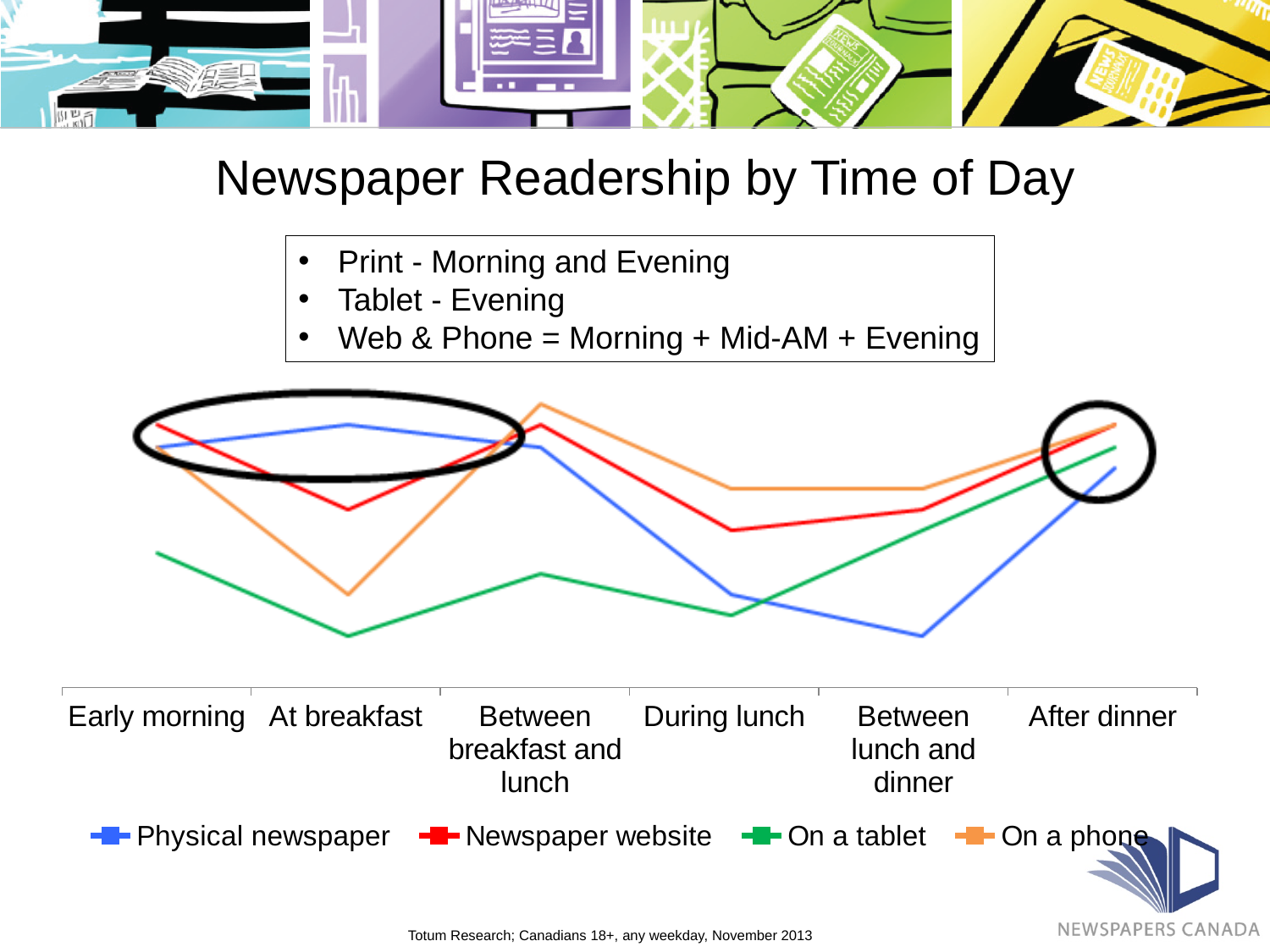
At which time of day is the "On a phone" series at its highest? Between breakfast and lunch Which series has the highest value at "During lunch"? On a phone What is the title of the chart? Newspaper Readership by Time of Day At which time of day is the "On a tablet" series at its lowest? At breakfast Does the "Physical newspaper" series rise or fall from "Between lunch and dinner" to "After dinner"? Rise How many time-of-day categories are shown on the x axis? 6 What kind of chart is shown on the slide? Line chart At which time of day is the "Physical newspaper" series at its lowest? Between lunch and dinner How many series does the legend list? 4 Which series is shown in green in the legend? On a tablet Which series has the lowest value at "Early morning"? On a tablet At "At breakfast", which is higher: "Physical newspaper" or "On a tablet"? Physical newspaper